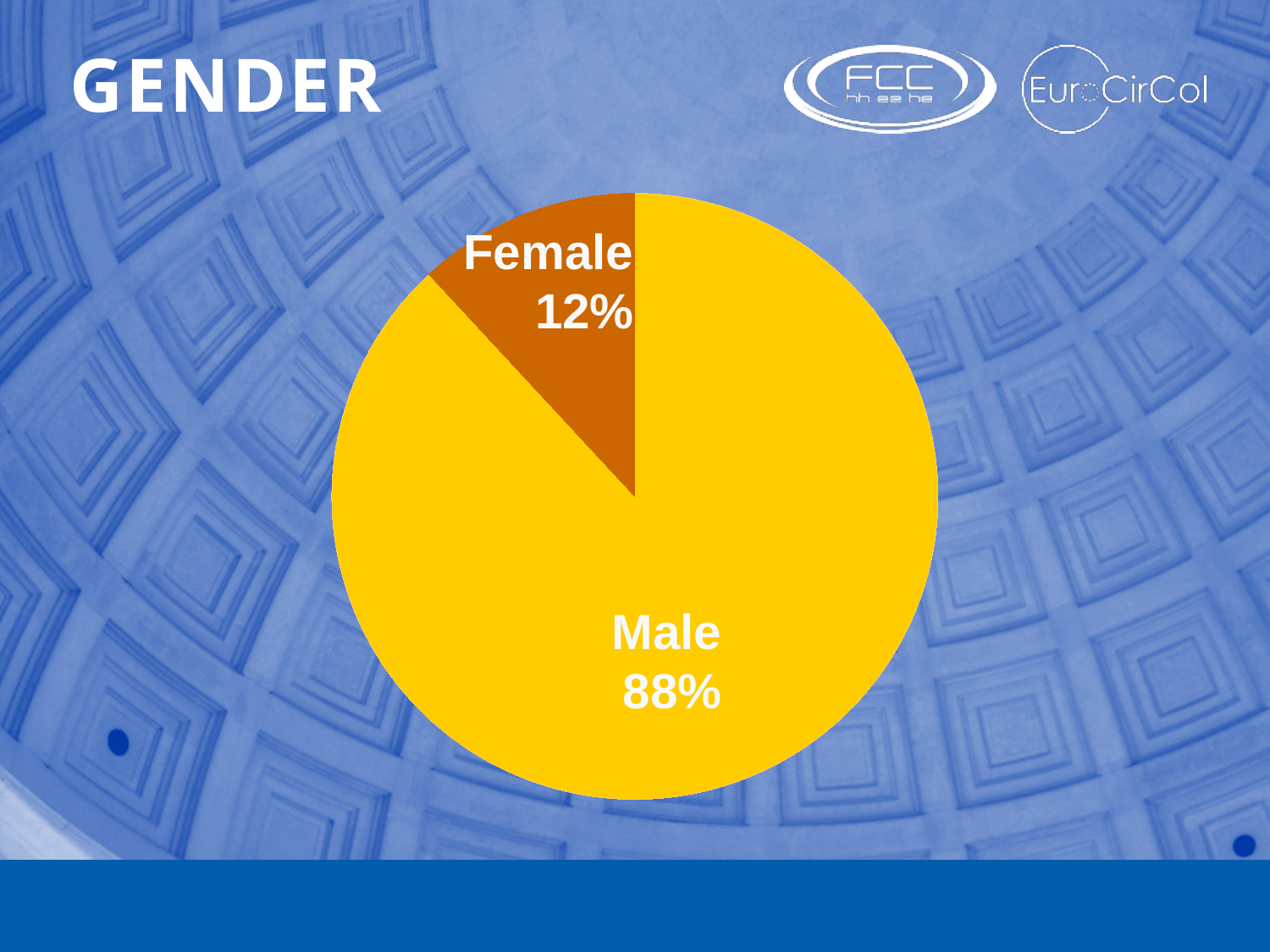
Which category has the largest slice of the pie? Male How many slices does the pie chart have? 2 What is the title of the slide containing the pie chart? GENDER Which is larger, the Male share or the Female share? Male What share of the pie is Male? 88% Which category has the smallest slice of the pie? Female What colour is the Male slice of the pie? yellow What share of the pie is Female? 12% What is the difference in percentage points between the Male and Female shares? 76 What kind of chart is shown on the slide? pie chart